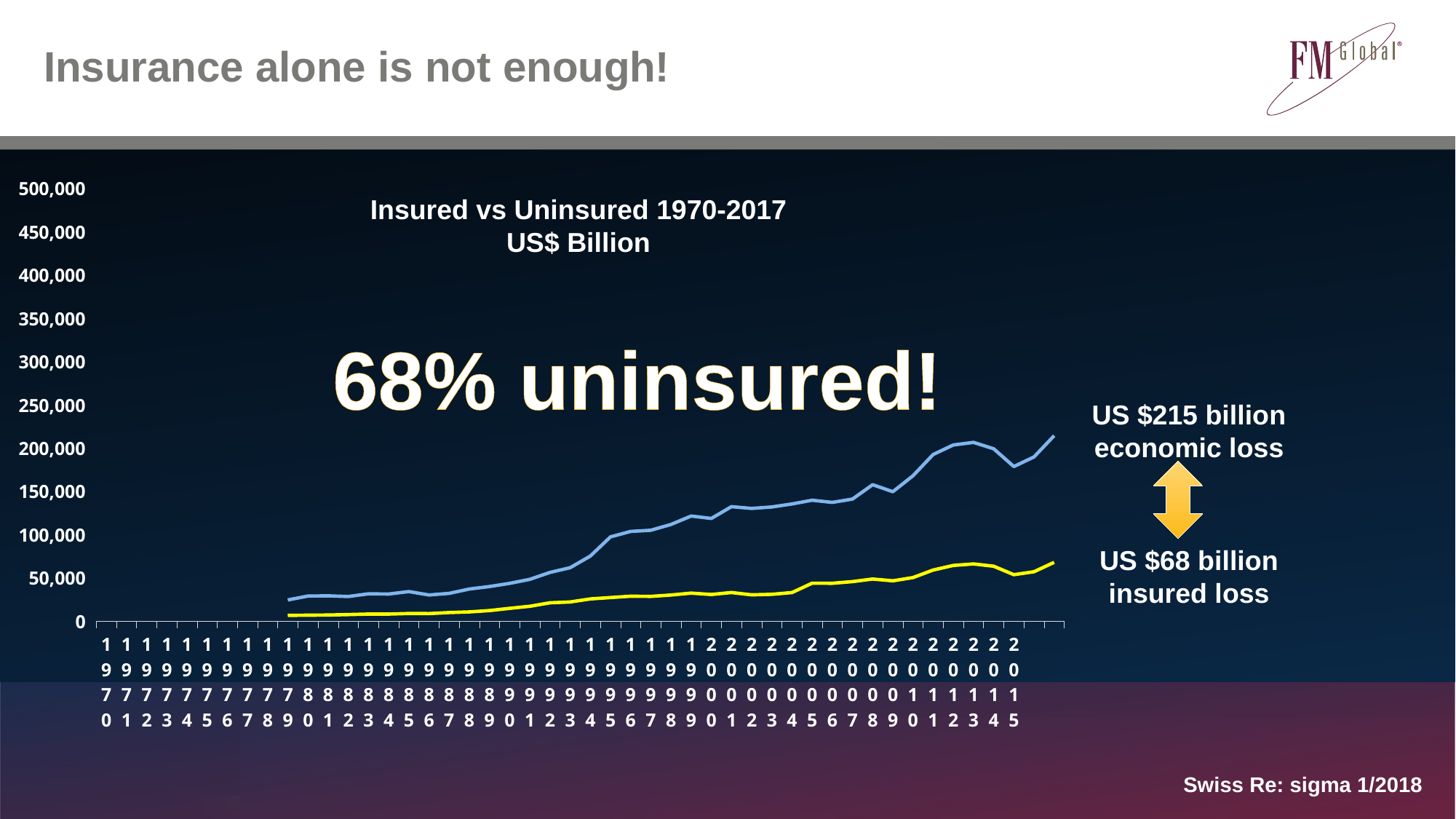
How many lines are plotted on the chart? 2 Does the blue economic loss line generally rise or fall from 1970 to 2017? rise Is the value of the blue economic loss line in 1990 greater or less than 100,000? less What percentage of losses does the slide say is uninsured? 68% Does the yellow insured loss line generally rise or fall over the period shown? rise What economic loss value is annotated next to the blue line? US $215 billion Is the value of the yellow insured loss line in 2010 greater or less than 100,000? less What is the title of the chart? Insured vs Uninsured 1970-2017 US$ Billion What type of chart is shown on the slide? line chart Which line is higher throughout the chart, the blue economic loss line or the yellow insured loss line? blue economic loss line What insured loss value is annotated next to the yellow line? US $68 billion